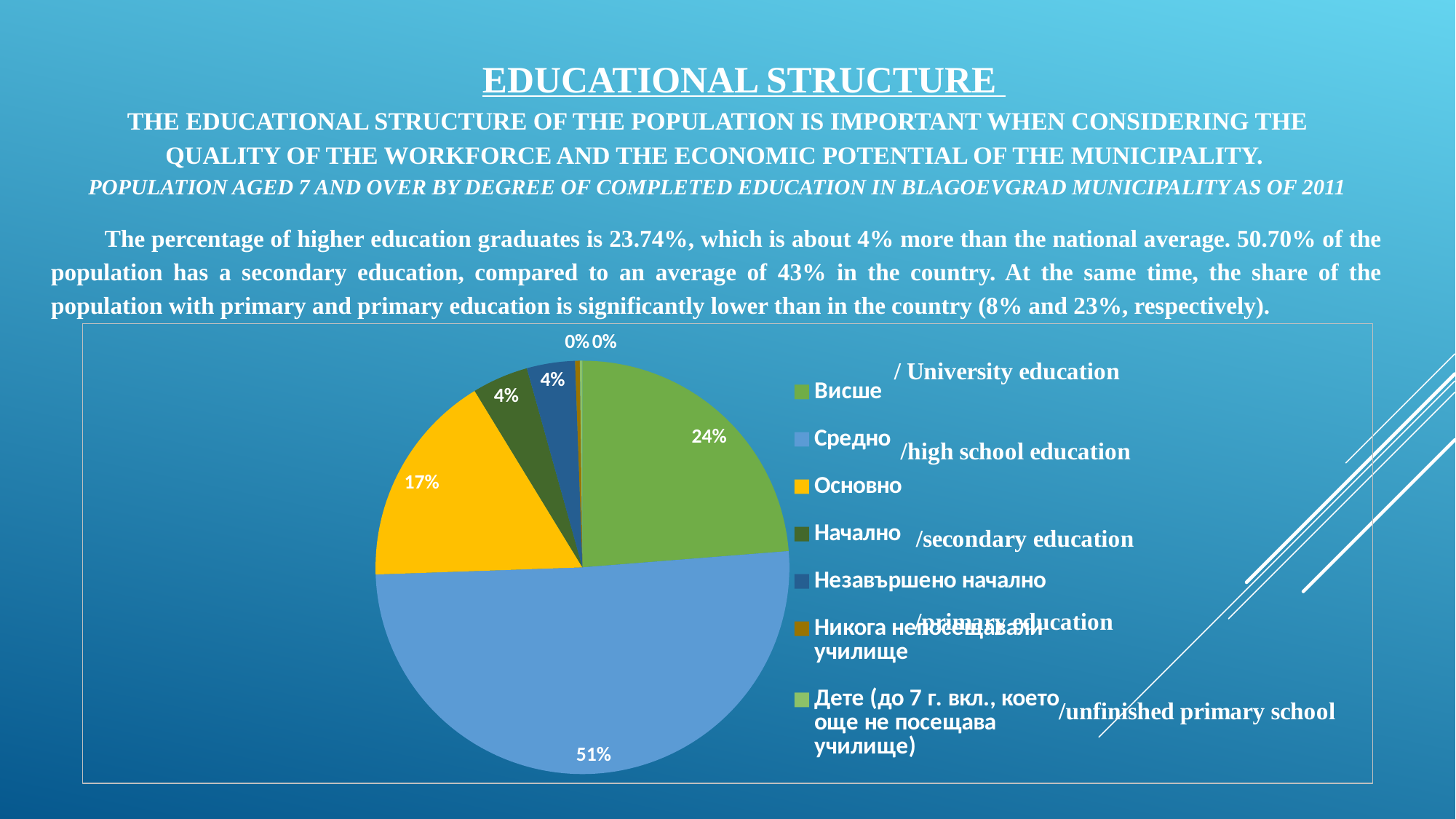
What colour is the Основно slice? yellow What kind of chart is shown on the slide? pie chart Which category has the largest slice of the pie? Средно How many entries does the legend list? 7 What is the value shown for the Незавършено начално slice? 4% What is the value shown for the Начално slice? 4% What share of the pie does the Средно (high school education) slice represent? 51% What is the value shown for the Основно slice? 17% What is the difference between the Средно slice and the Висше slice? 27% What is the difference between the Основно slice and the Начално slice? 13% Which is larger, the Висше slice or the Основно slice? Висше What is the value shown for the Висше (University education) slice? 24%